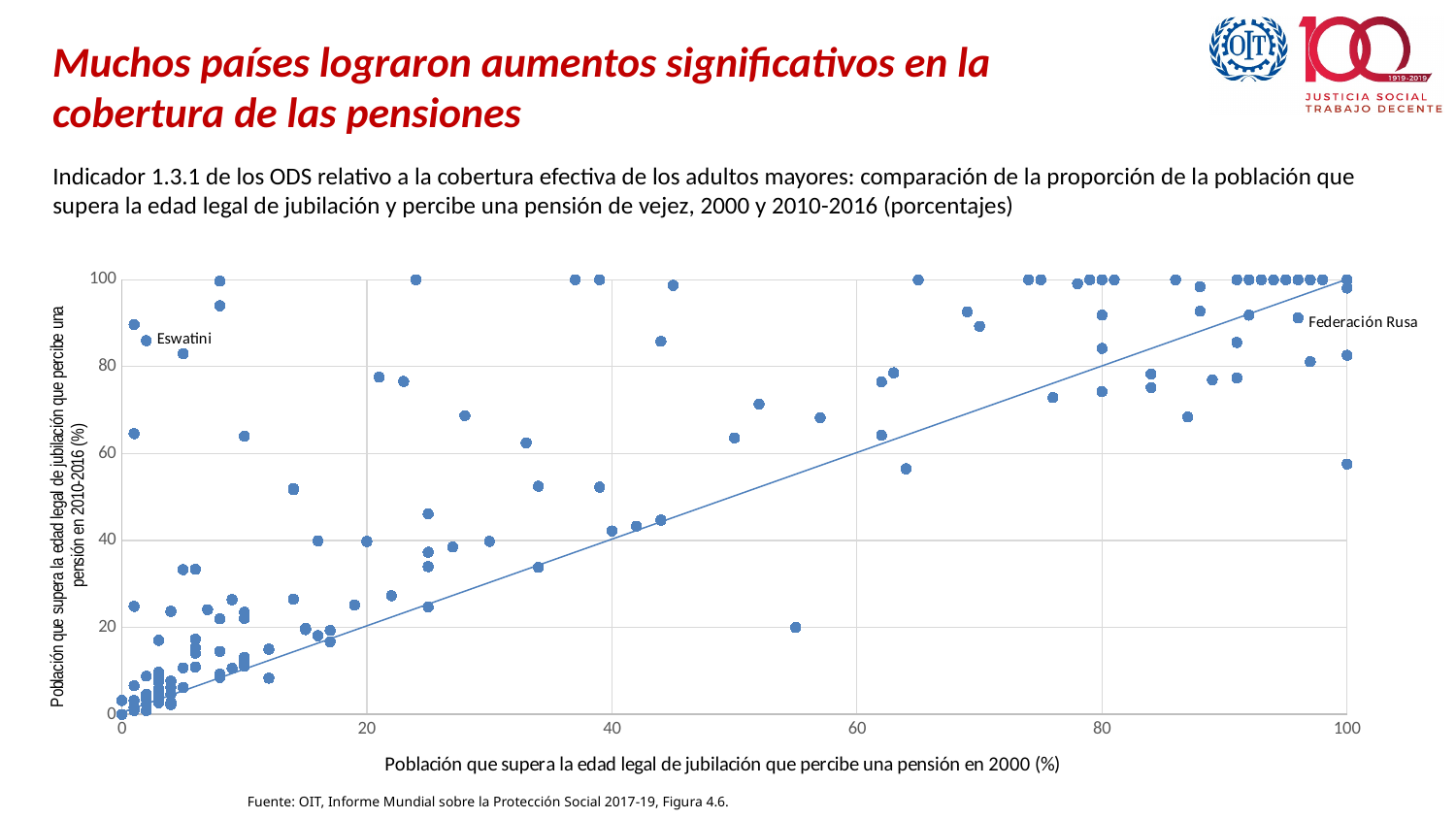
Which labelled country has the higher value on the vertical axis (pensión en 2010-2016): Eswatini or Federación Rusa? Federación Rusa Is the value for Federación Rusa on the vertical axis (pensión en 2010-2016) greater or less than 80? greater What is the maximum value shown on the horizontal axis? 100 What kind of chart is shown on the slide? Scatter chart What is the label of the horizontal axis? Población que supera la edad legal de jubilación que percibe una pensión en 2000 (%) Which two countries are labelled on the chart? Eswatini and Federación Rusa Is the value for Federación Rusa on the horizontal axis (pensión en 2000) greater or less than 80? greater Do the plotted points generally rise or fall as the value on the horizontal axis increases? Rise Is the value for Eswatini on the vertical axis (pensión en 2010-2016) greater or less than 80? greater Which labelled country has the higher value on the horizontal axis (pensión en 2000): Eswatini or Federación Rusa? Federación Rusa